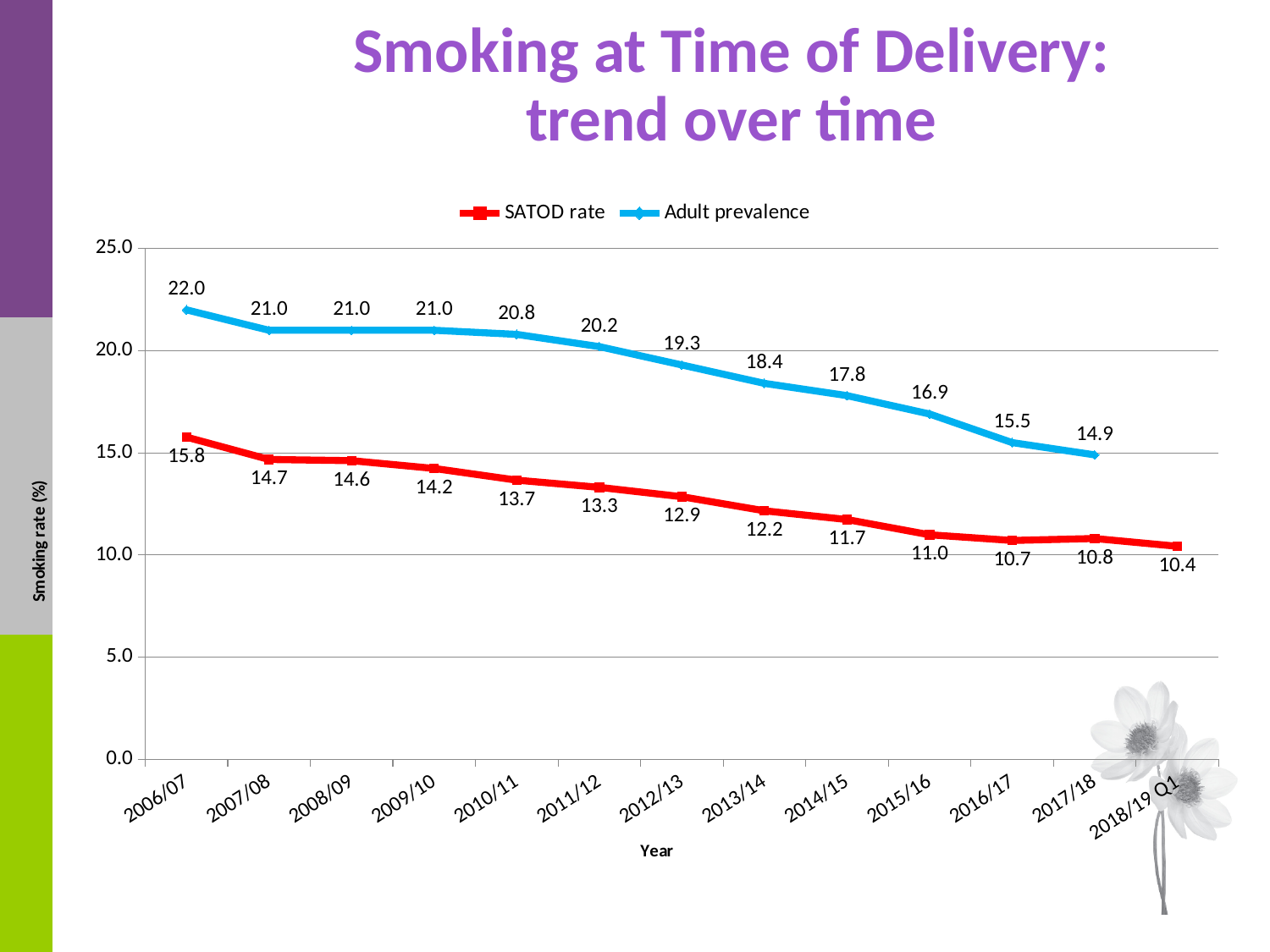
What type of chart is shown on the slide? Line chart In which year is the SATOD rate lowest? 2018/19 Q1 How many years are shown on the x axis? 13 What is the SATOD rate for 2018/19 Q1? 10.4 Which is larger in 2010/11, the SATOD rate or the Adult prevalence? Adult prevalence In which year is the Adult prevalence highest? 2006/07 What is the Adult prevalence value for 2013/14? 18.4 How many series does the legend list? 2 Does the SATOD rate generally rise or fall from 2006/07 to 2018/19 Q1? Fall What is the SATOD rate for 2006/07? 15.8 What is the difference between the Adult prevalence and the SATOD rate in 2017/18? 4.1 What is the label on the y axis? Smoking rate (%)